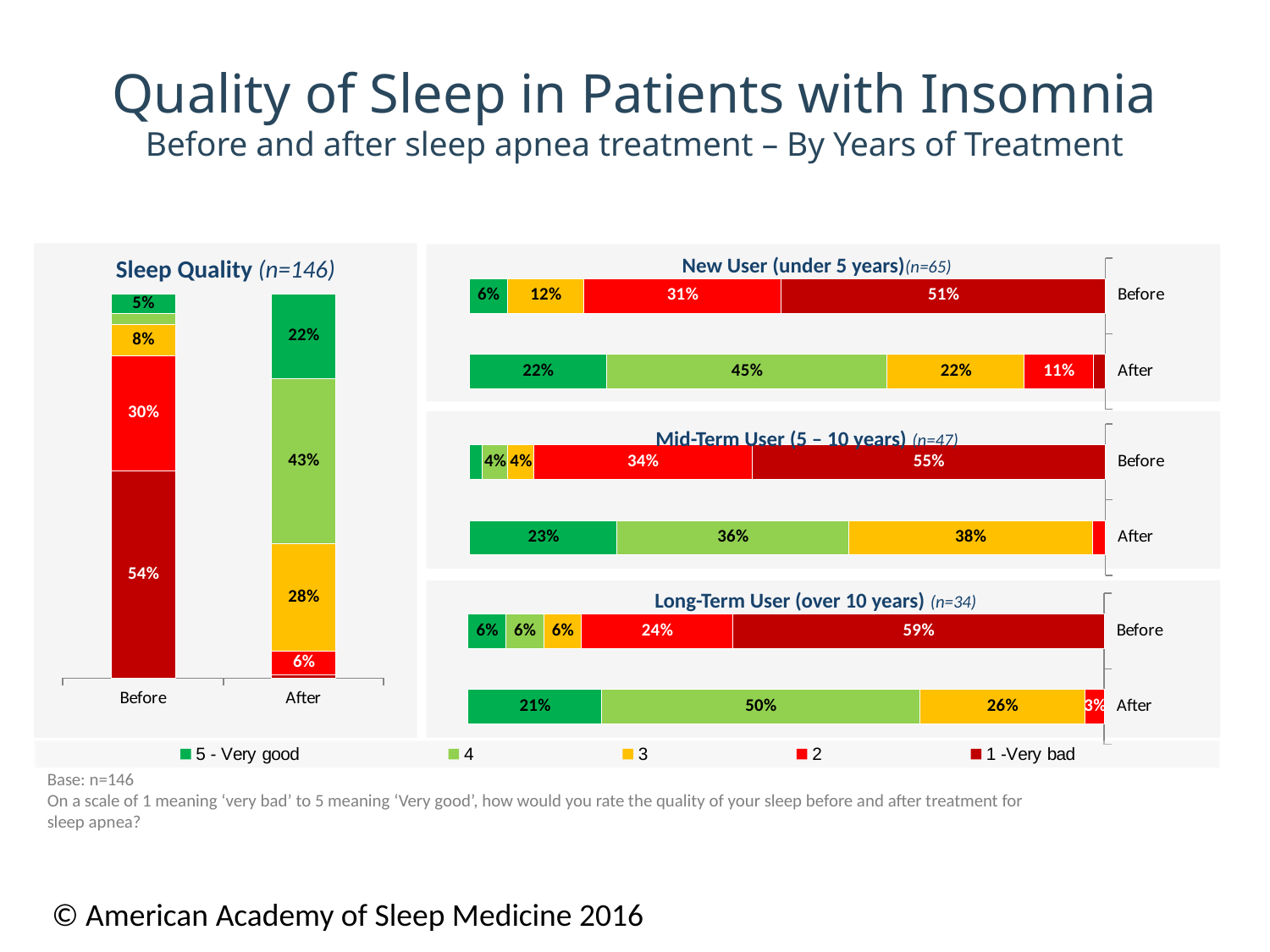
In the Long-Term User (over 10 years) chart, what percentage rated their sleep '4' after treatment? 50% In the Mid-Term User (5 – 10 years) chart, which rating has the largest share in the Before bar? 1 - Very bad How many series does the legend at the bottom of the slide list? 5 In the Mid-Term User (5 – 10 years) chart, what percentage rated their sleep '3' after treatment? 38% What kind of chart is the Sleep Quality (n=146) chart? Stacked bar chart In the Sleep Quality (n=146) chart, what is the difference between the '2' rating before treatment and the '2' rating after treatment? 24% In the Sleep Quality (n=146) chart, what percentage of patients rated their sleep '1 - Very bad' before treatment? 54% In the Sleep Quality (n=146) chart, what percentage of patients rated their sleep '5 - Very good' after treatment? 22% In the Long-Term User (over 10 years) chart, what percentage rated their sleep '1 - Very bad' before treatment? 59% In the Long-Term User (over 10 years) chart, is the '1 - Very bad' share before treatment larger or smaller than the '2' share before treatment? larger In the New User (under 5 years) chart, what percentage rated their sleep '1 - Very bad' before treatment? 51% In the New User (under 5 years) chart, what percentage rated their sleep '4' after treatment? 45%